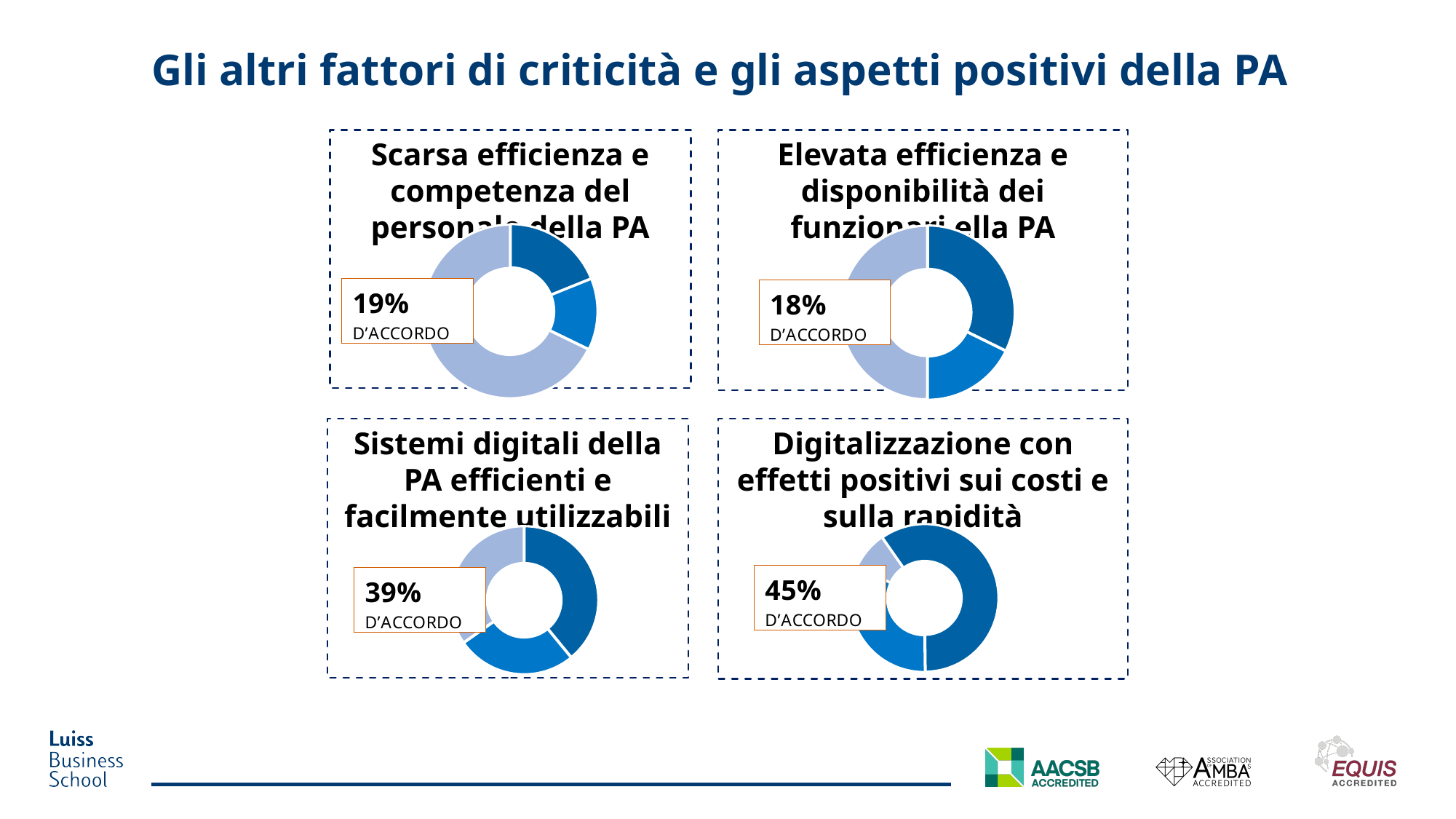
Across the four charts on the slide, which statement has the highest D'ACCORDO percentage? Digitalizzazione con effetti positivi sui costi e sulla rapidità In the bottom-left chart (Sistemi digitali della PA efficienti e facilmente utilizzabili), what percentage is reported as D'ACCORDO? 39% What type of chart is used for each of the four statements on the slide? Donut (pie) chart In the top-left chart (Scarsa efficienza e competenza del personale della PA), what percentage is reported as D'ACCORDO? 19% How many slices does each donut chart on the slide contain? 3 Across the four charts on the slide, which statement has the lowest D'ACCORDO percentage? Elevata efficienza e disponibilità dei funzionari della PA What is the difference between the D'ACCORDO percentage in the top-left chart (Scarsa efficienza) and the top-right chart (Elevata efficienza)? 1 percentage point In the bottom-right chart (Digitalizzazione con effetti positivi sui costi e sulla rapidità), what percentage is reported as D'ACCORDO? 45% What is the difference between the D'ACCORDO percentage in the bottom-right chart (Digitalizzazione) and the bottom-left chart (Sistemi digitali)? 6 percentage points Which has a larger D'ACCORDO percentage: the bottom-left chart (Sistemi digitali della PA) or the top-left chart (Scarsa efficienza e competenza)? Sistemi digitali della PA efficienti e facilmente utilizzabili How many charts are shown on the slide? 4 In the top-right chart (Elevata efficienza e disponibilità dei funzionari della PA), what percentage is reported as D'ACCORDO? 18%